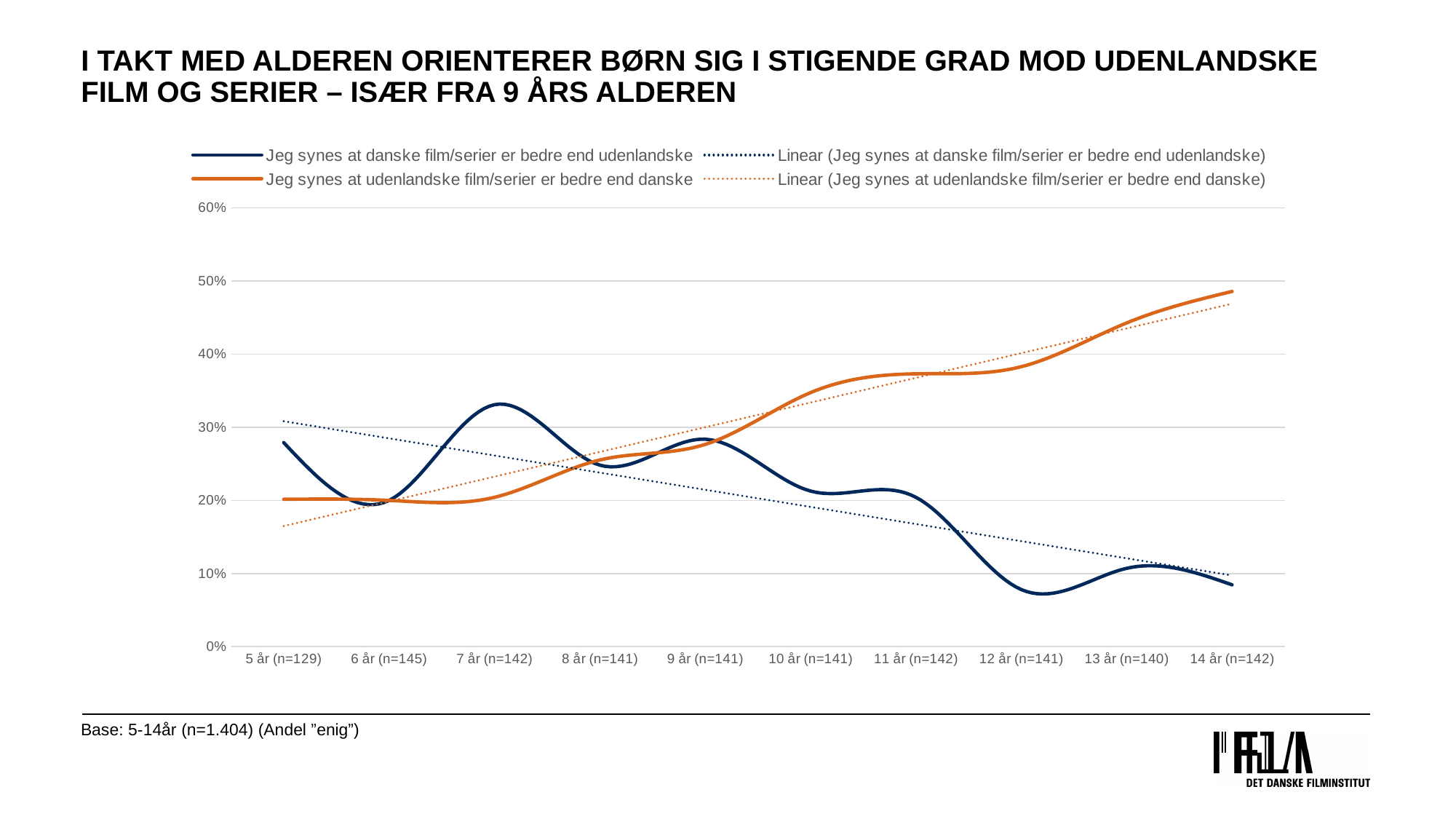
Is the value for "Jeg synes at udenlandske film/serier er bedre end danske" at 14 år (n=142) greater or less than 40%? greater Is the value for "Jeg synes at danske film/serier er bedre end udenlandske" at 7 år (n=142) greater or less than 30%? greater How many age groups are shown along the x axis? 10 What kind of chart is shown on the slide? line chart At 7 år (n=142), which series has the higher value? Jeg synes at danske film/serier er bedre end udenlandske Does the series "Jeg synes at danske film/serier er bedre end udenlandske" rise or fall overall from 5 år to 14 år? fall Does the series "Jeg synes at udenlandske film/serier er bedre end danske" rise or fall along the x axis from 5 år to 14 år? rise At 14 år (n=142), which series has the higher value? Jeg synes at udenlandske film/serier er bedre end danske For the series "Jeg synes at udenlandske film/serier er bedre end danske", at which age group is the value highest? 14 år (n=142) What base is stated below the chart? Base: 5-14år (n=1.404) (Andel "enig") How many entries does the legend list? 4 Is the value for "Jeg synes at danske film/serier er bedre end udenlandske" at 12 år (n=141) greater or less than 10%? less